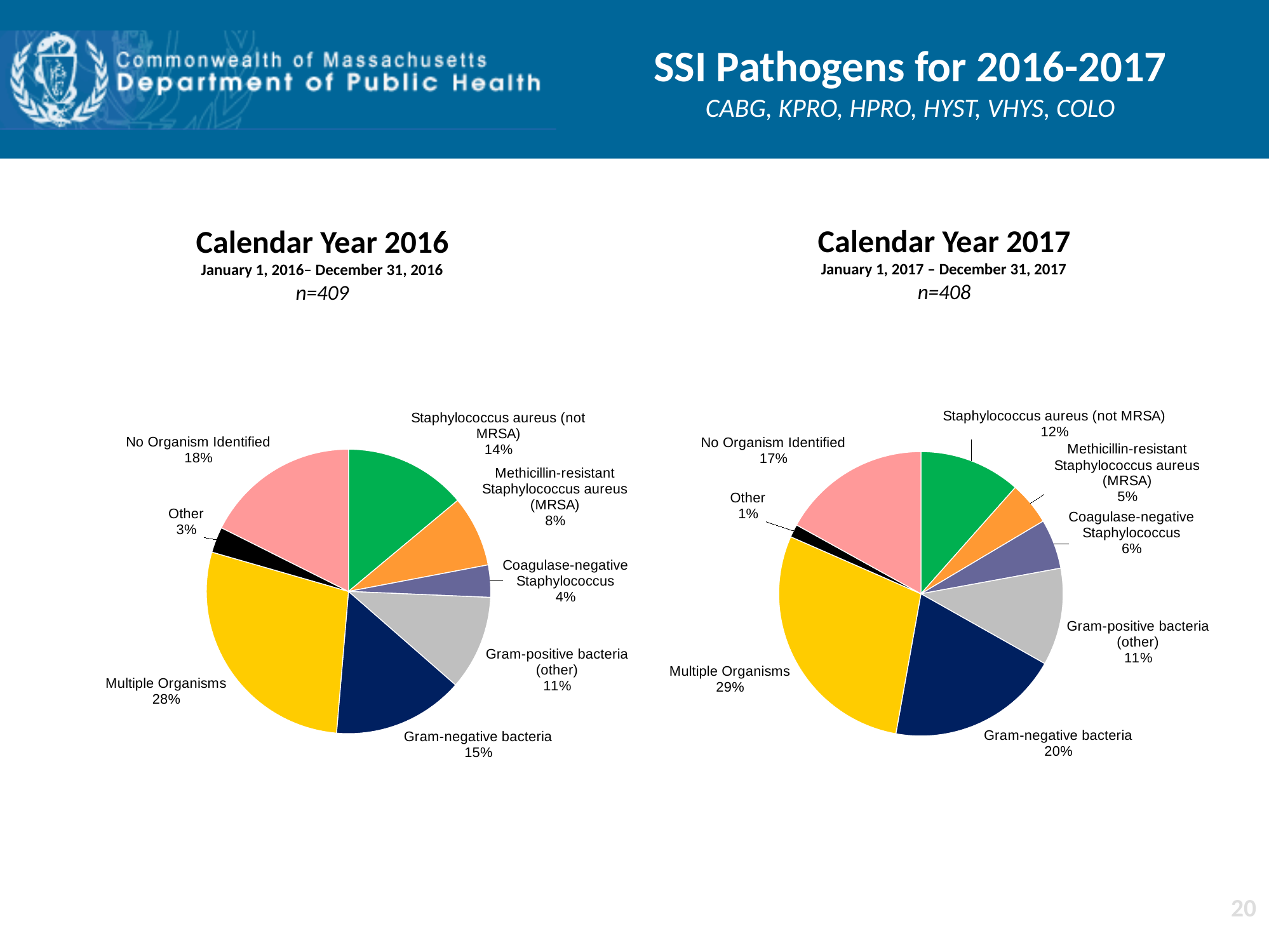
In the Calendar Year 2016 pie chart, what share is labelled for Multiple Organisms? 28% What is the n value shown for the Calendar Year 2017 chart? n=408 In the Calendar Year 2017 pie chart, what share is labelled for Gram-negative bacteria? 20% In the Calendar Year 2017 pie chart, which category has the smallest share? Other How many categories does the Calendar Year 2017 pie chart show? 8 In the Calendar Year 2016 pie chart, what share is labelled for Methicillin-resistant Staphylococcus aureus (MRSA)? 8% In the Calendar Year 2016 pie chart, which category has the largest share? Multiple Organisms In the Calendar Year 2017 pie chart, what share is labelled for Other? 1% In the Calendar Year 2016 pie chart, which is larger: Staphylococcus aureus (not MRSA) or Gram-positive bacteria (other)? Staphylococcus aureus (not MRSA) What kind of chart is used for Calendar Year 2016? Pie chart In the Calendar Year 2016 pie chart, what is the difference between the shares for No Organism Identified and Gram-negative bacteria? 3% In the Calendar Year 2017 pie chart, what is the difference between the shares for Multiple Organisms and Gram-positive bacteria (other)? 18%